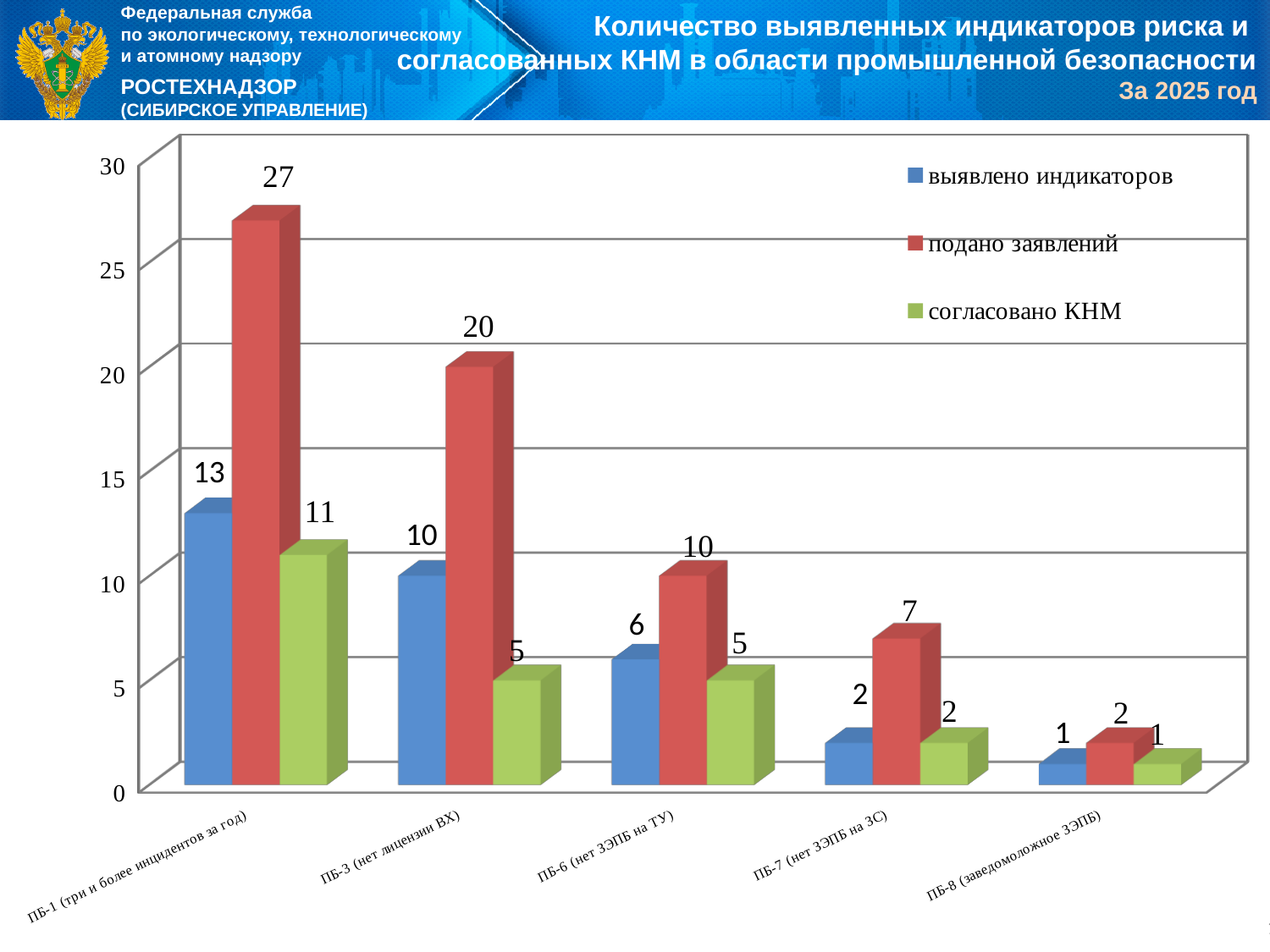
How many categories are shown on the x axis? 5 Which series is shown in red in the legend? подано заявлений What is the value of "выявлено индикаторов" for ПБ-3 (нет лицензии ВХ)? 10 What is the value of "подано заявлений" for ПБ-1 (три и более инцидентов за год)? 27 How many series does the legend list? 3 What is the value of "подано заявлений" for ПБ-7 (нет ЗЭПБ на ЗС)? 7 Which is larger: "согласовано КНМ" for ПБ-1 or "согласовано КНМ" for ПБ-3? ПБ-1 What kind of chart is shown on the slide? Bar chart What is the value of "согласовано КНМ" for ПБ-6 (нет ЗЭПБ на ТУ)? 5 What is the difference between "подано заявлений" and "выявлено индикаторов" for ПБ-1 (три и более инцидентов за год)? 14 Which category has the lowest value for "выявлено индикаторов"? ПБ-8 (заведомоложное ЗЭПБ) Which category has the highest value for "подано заявлений"? ПБ-1 (три и более инцидентов за год)